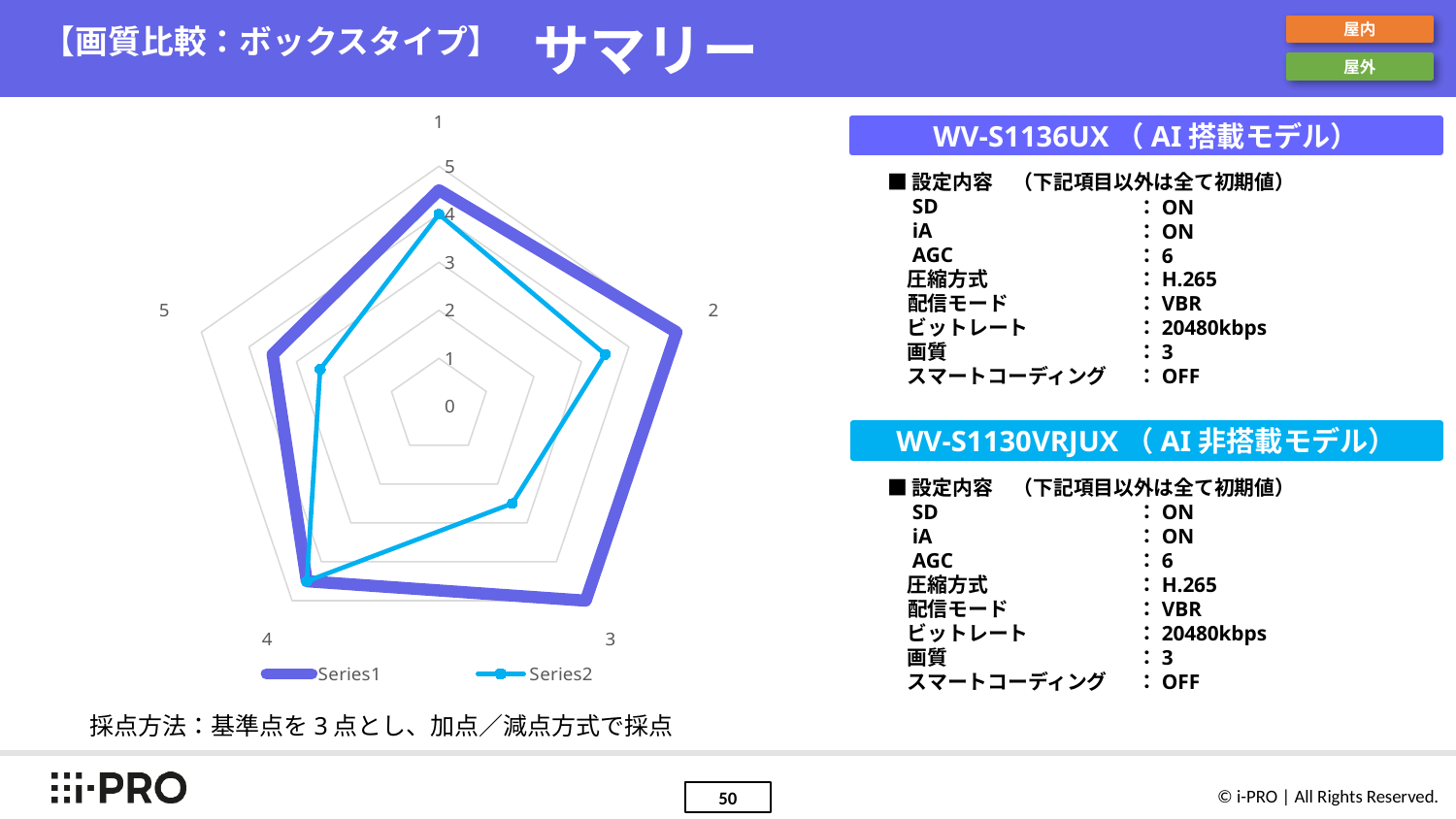
Is the value of Series2 for category 1 greater or less than 3? greater Is the value of Series2 for category 5 greater or less than 5? less How many series does the chart legend list? 2 How many categories (axes) does the radar chart have? 5 What is the highest value shown on the radar chart's axis scale? 5 Which is larger for category 2: Series1 or Series2? Series1 Is the value of Series2 for category 3 greater or less than 3? less What kind of chart is shown on the slide? radar chart Which series is drawn with the thick purple line? Series1